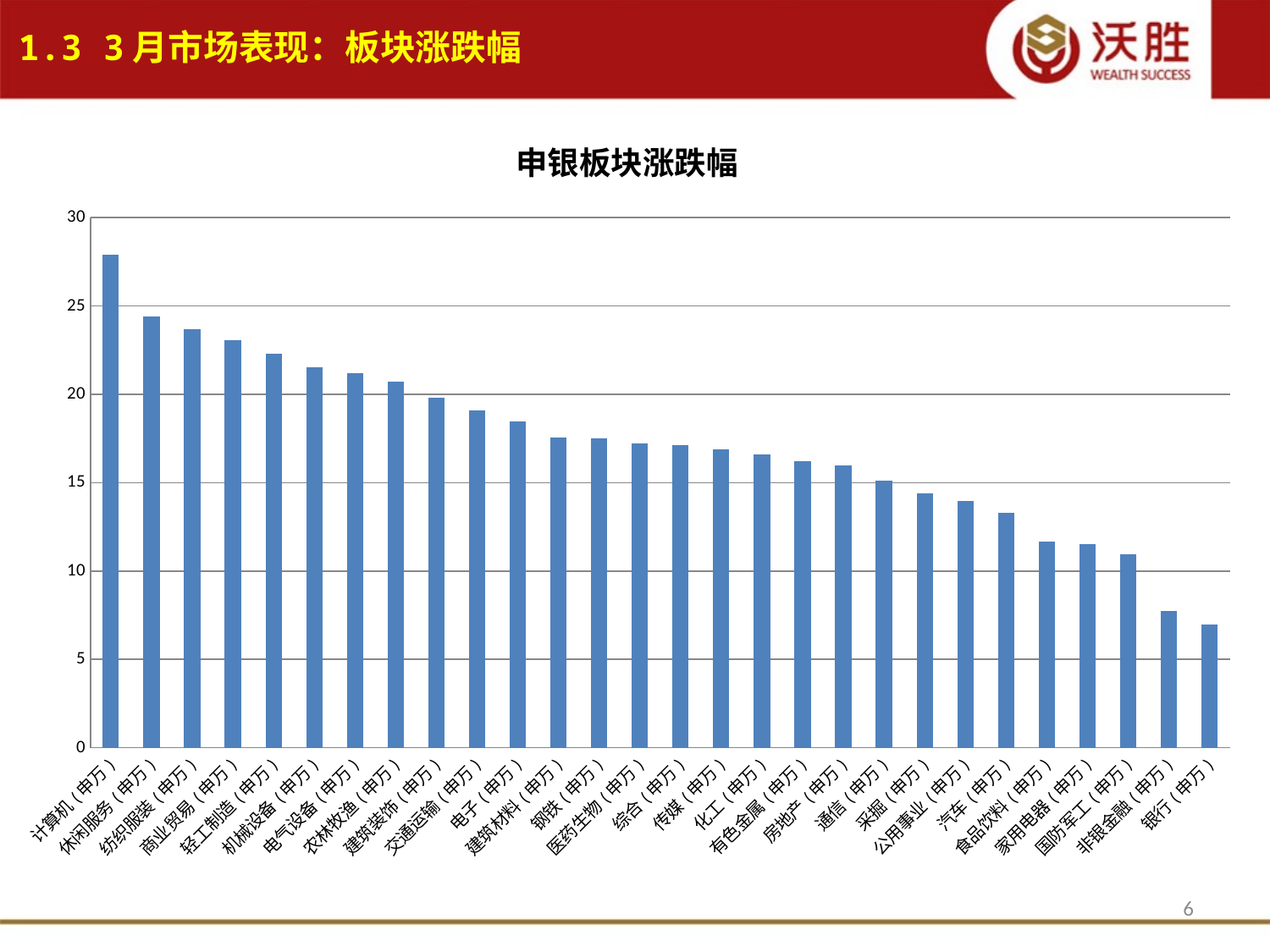
Is the value for 银行（申万） greater or less than 10? less Is the value for 电子（申万） greater or less than 20? less Which sector has the highest value in the chart? 计算机（申万） Which has the larger value, 纺织服装（申万） or 汽车（申万）? 纺织服装（申万） What kind of chart is shown on the slide? bar chart Which sector has the lowest value in the chart? 银行（申万） Do the values rise or fall moving from left to right along the x axis? fall Is the value for 采掘（申万） greater or less than 15? less How many categories (sectors) are plotted in the chart? 28 Which has the larger value, 非银金融（申万） or 国防军工（申万）? 国防军工（申万） What is the title of the chart? 申银板块涨跌幅